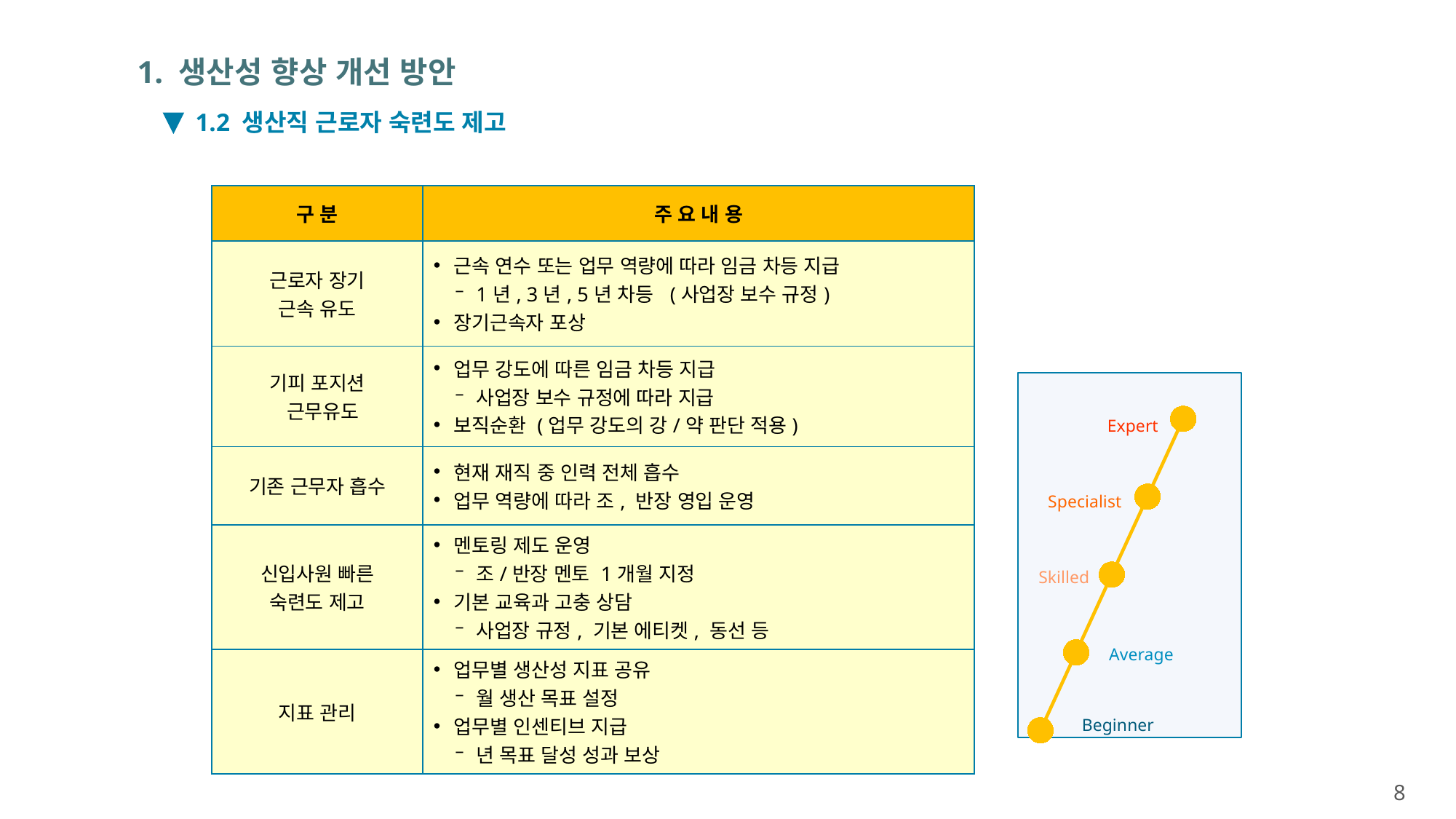
How many data points are plotted on the line chart on the right? 5 Does the line on the chart on the right rise or fall from Beginner to Expert? rise On the line chart on the right, which label comes immediately after Beginner going up the line? Average On the line chart on the right, which point is higher: Skilled or Average? Skilled What colour are the markers and line on the chart on the right? yellow Which label is at the highest point of the line chart on the right? Expert What kind of chart is shown on the right side of the slide? line chart Which label is at the lowest point of the line chart on the right? Beginner On the line chart on the right, which point is higher: Specialist or Expert? Expert